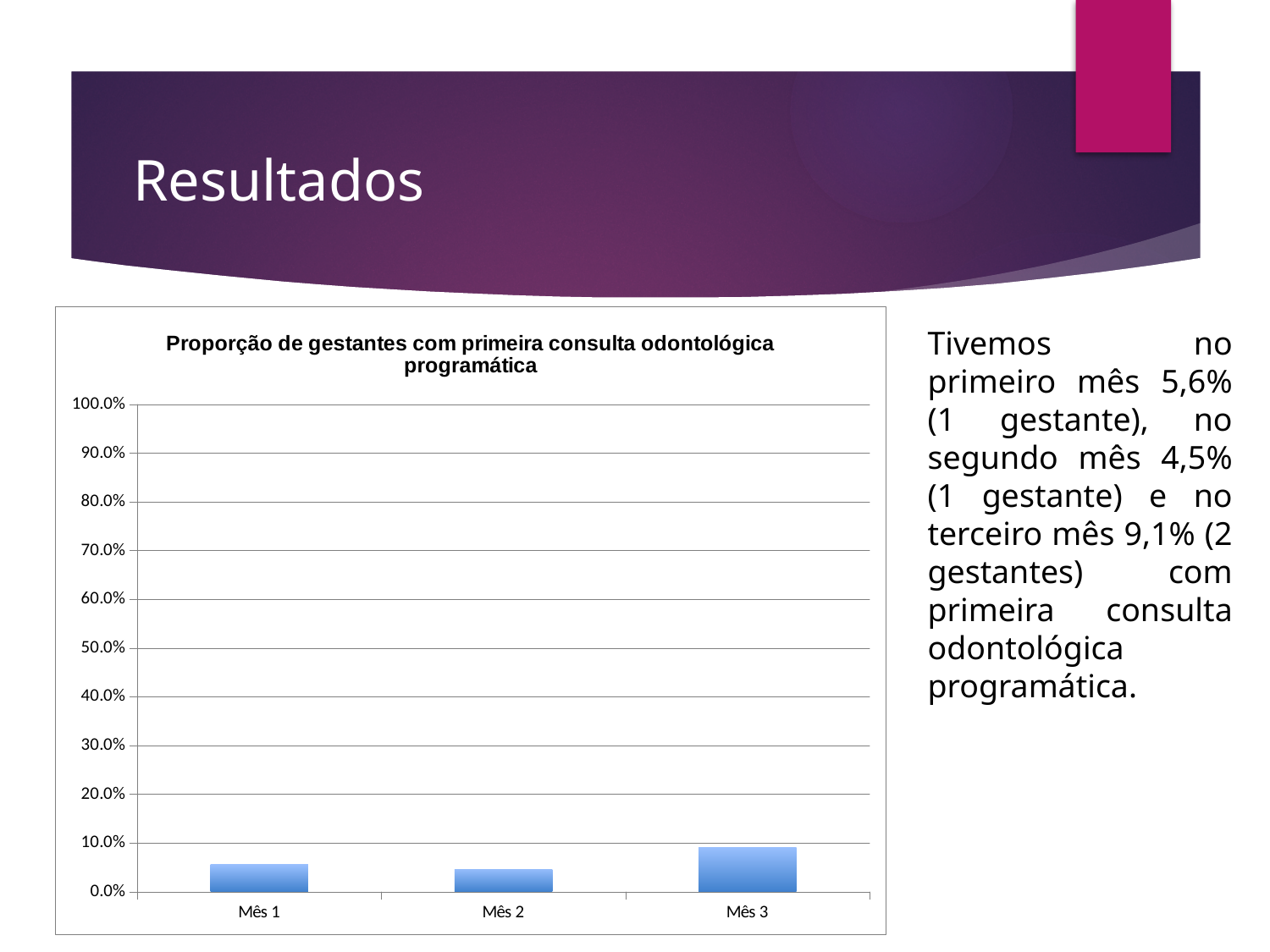
Does the value rise or fall from Mês 2 to Mês 3? rise Which is larger, the value for Mês 1 or the value for Mês 3? Mês 3 Which month has the highest bar in the chart? Mês 3 Is the value for Mês 1 greater or less than 10.0%? less Is the value for Mês 2 greater or less than 20.0%? less What is the title of the chart? Proporção de gestantes com primeira consulta odontológica programática Which is larger, the value for Mês 3 or the value for Mês 2? Mês 3 Is the value for Mês 3 greater or less than 10.0%? less What kind of chart is shown on the slide? bar chart What is the highest value shown on the y axis of the chart? 100.0% How many categories (months) are plotted on the x axis of the chart? 3